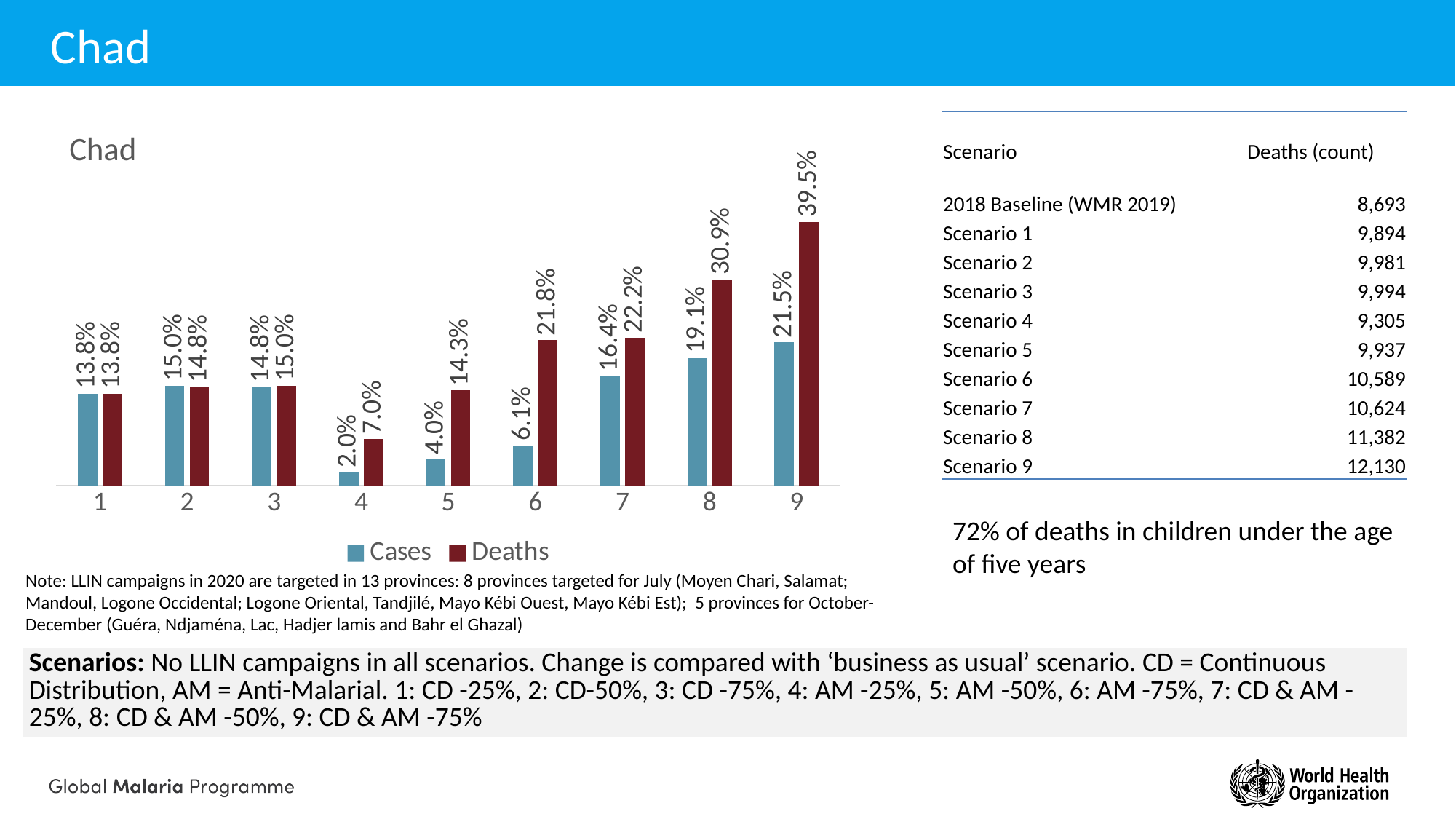
Which scenario has the lowest Cases value? 4 What is the Cases value for scenario 4? 2.0% Do the Deaths values rise or fall from scenario 6 to scenario 9? Rise How many scenarios are shown on the x axis of the chart? 9 Which is larger for scenario 7, the Cases value or the Deaths value? Deaths How many series does the chart legend list? 2 Which scenario has the highest Deaths value? 9 What is the title of the chart? Chad What kind of chart is shown on the slide? Bar chart What is the difference between the Deaths and Cases values for scenario 8? 11.8% What is the Deaths value for scenario 6? 21.8% What is the Cases value for scenario 9? 21.5%